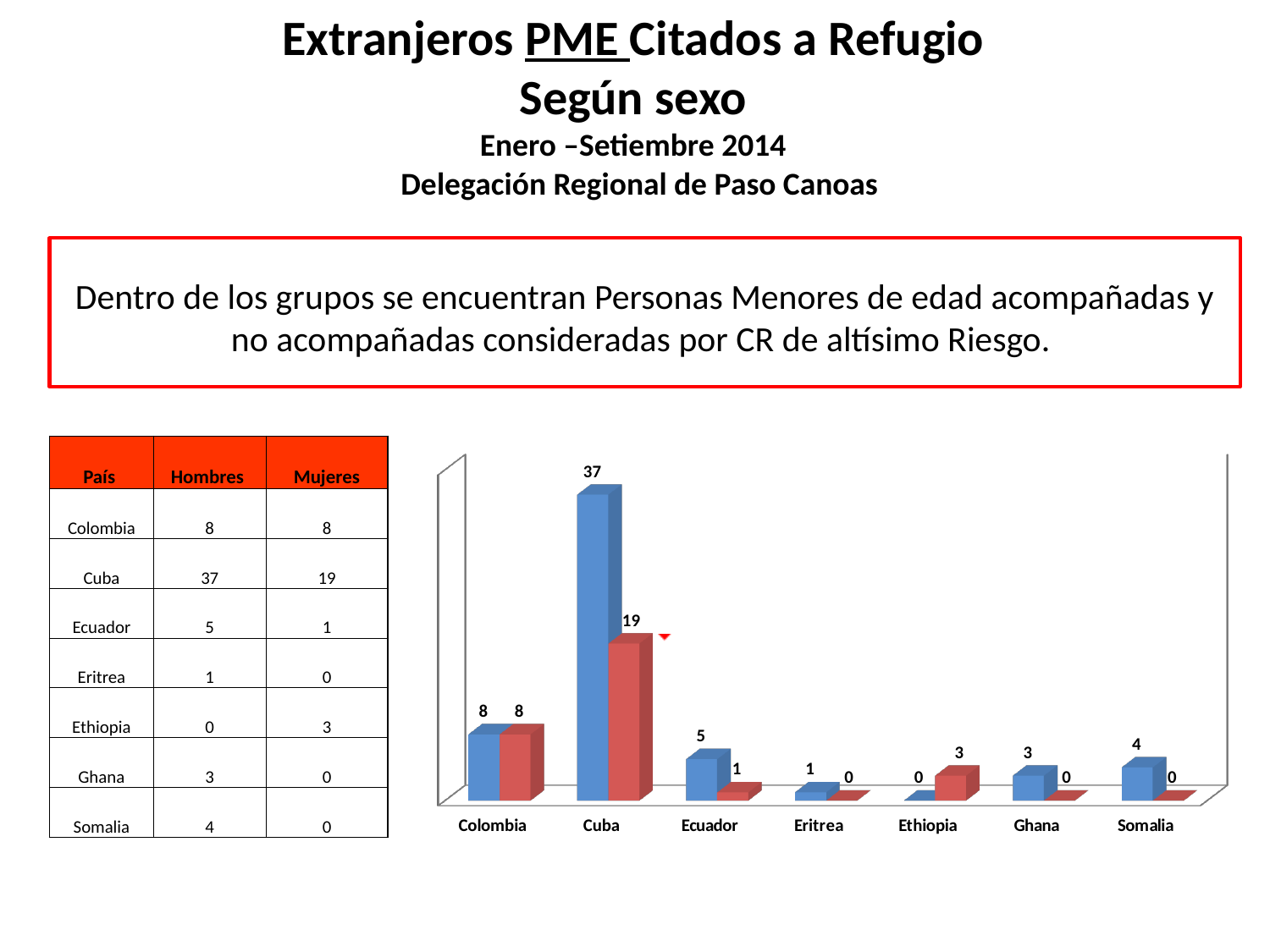
What type of chart is shown on the slide? bar chart Which country has the highest blue (Hombres) bar? Cuba Which is larger for Somalia, the blue (Hombres) bar or the red (Mujeres) bar? blue (Hombres) What is the value of the red (Mujeres) bar for Ethiopia? 3 What is the value of the blue (Hombres) bar for Cuba? 37 How many countries are shown on the x axis of the chart? 7 What is the value of the red (Mujeres) bar for Cuba? 19 What is the value of the blue (Hombres) bar for Ecuador? 5 What is the total of the blue and red bars for Colombia? 16 What colour are the bars representing Hombres in the chart? blue What is the difference between the blue (Hombres) and red (Mujeres) bars for Cuba? 18 Which country has the lowest blue (Hombres) bar? Ethiopia